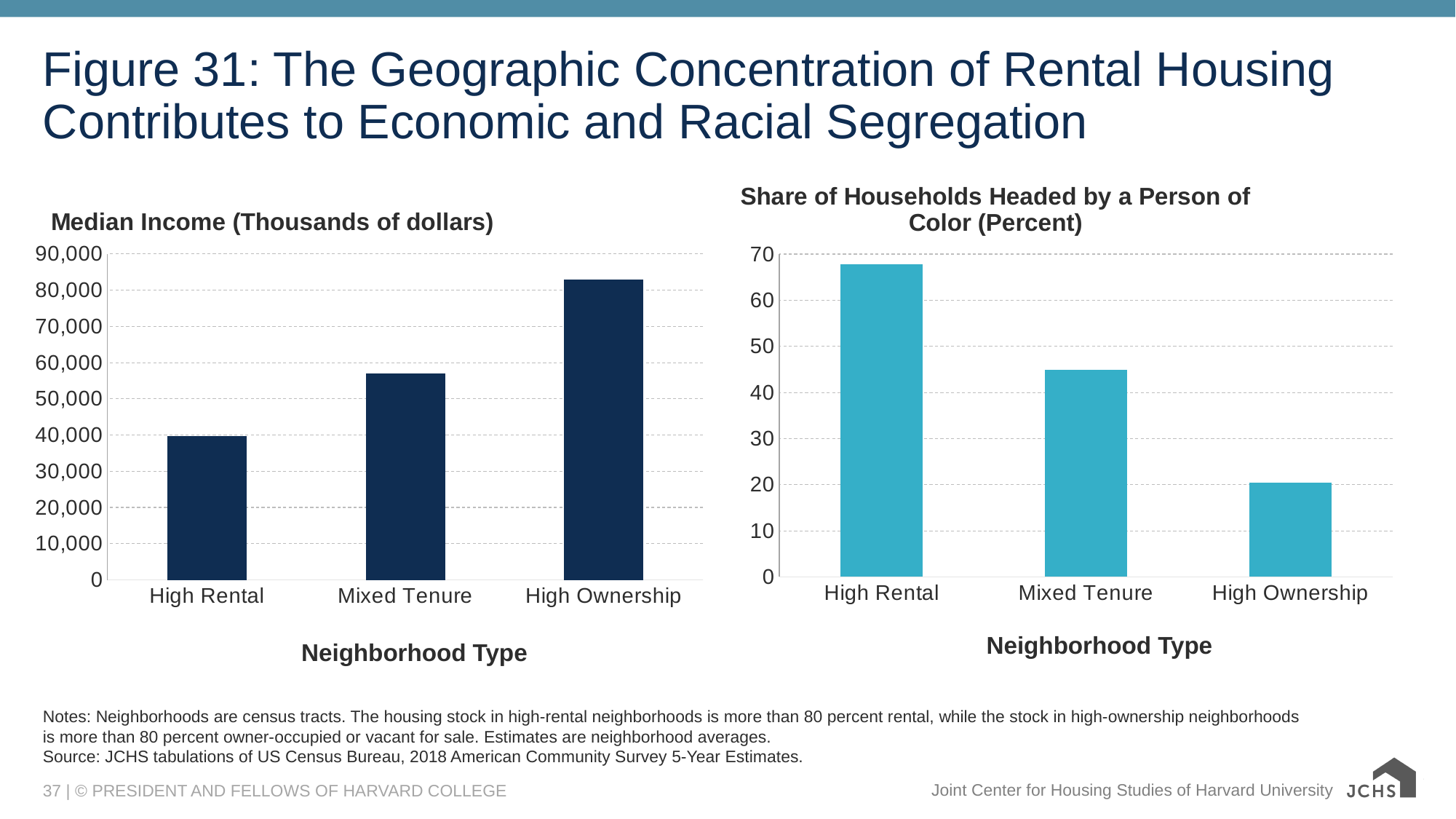
In the Share of Households Headed by a Person of Color chart, do the values rise or fall from High Rental to High Ownership? fall In the Share of Households Headed by a Person of Color chart, is the value for High Rental greater or less than 60? greater In the Share of Households Headed by a Person of Color chart, which neighborhood type has the lowest share? High Ownership In the Share of Households Headed by a Person of Color chart, is the value for High Ownership greater or less than 30? less What kind of chart is the Share of Households Headed by a Person of Color chart? bar chart In the Share of Households Headed by a Person of Color chart, which neighborhood type has the highest share? High Rental In the Median Income chart, which neighborhood type has the highest median income? High Ownership How many neighborhood types are shown in the Median Income chart? 3 In the Median Income chart, is the value for Mixed Tenure greater or less than 50,000? greater In the Median Income chart, which neighborhood type has the lowest median income? High Rental